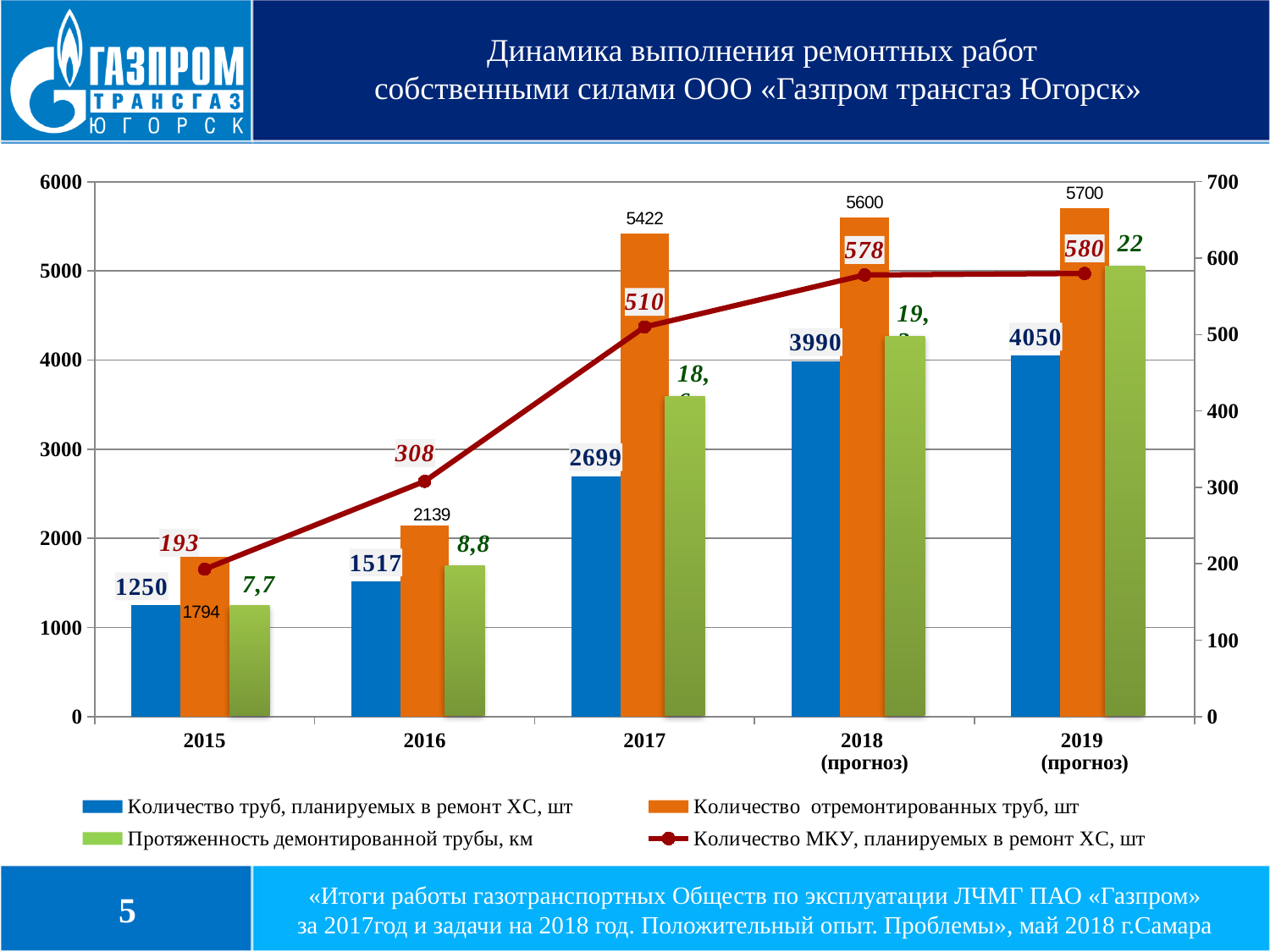
What is the value of «Количество МКУ, планируемых в ремонт ХС, шт» for 2016? 308 In which year is «Количество отремонтированных труб, шт» the highest? 2019 (прогноз) How many series does the legend list? 4 In which year is «Количество труб, планируемых в ремонт ХС, шт» the lowest? 2015 What is the value of «Протяженность демонтированной трубы, км» for 2019 (прогноз)? 22 By how much does «Количество МКУ, планируемых в ремонт ХС, шт» increase from 2016 to 2017? 202 What is the value of «Количество отремонтированных труб, шт» for 2015? 1794 Does «Количество МКУ, планируемых в ремонт ХС, шт» rise or fall from 2015 to 2019? rise For 2016, which is larger: «Количество труб, планируемых в ремонт ХС, шт» or «Количество отремонтированных труб, шт»? Количество отремонтированных труб, шт How many years (categories) are shown on the x axis? 5 What is the value of «Количество труб, планируемых в ремонт ХС, шт» for 2017? 2699 What is the difference in «Количество отремонтированных труб, шт» between 2018 (прогноз) and 2017? 178